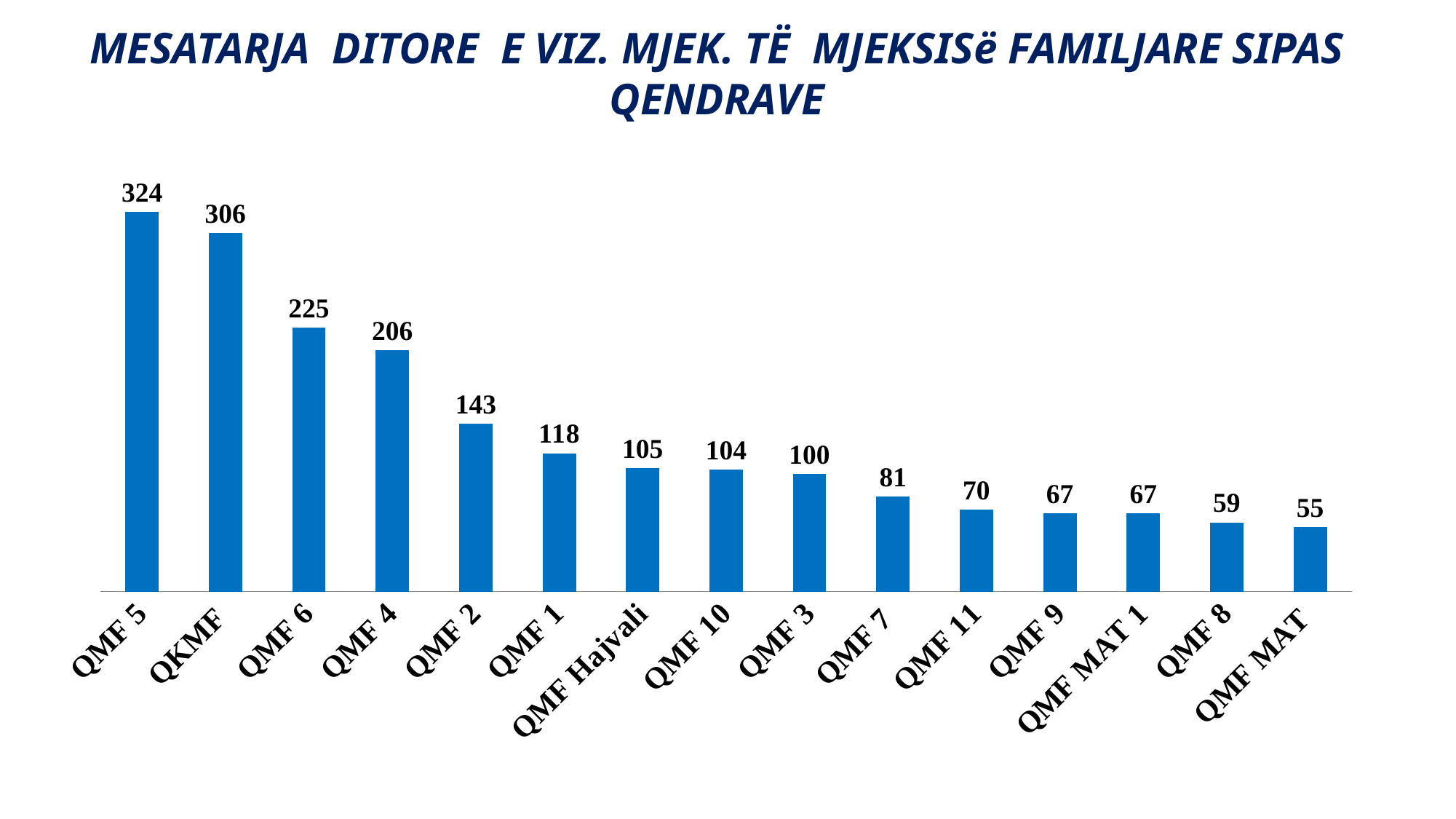
What is the title of the chart? MESATARJA DITORE E VIZ. MJEK. TË MJEKSISë FAMILJARE SIPAS QENDRAVE Which category has the lowest value? QMF MAT Which category has the highest value? QMF 5 What kind of chart is shown on the slide? Bar chart What is the difference between the values for QMF 6 and QMF 4? 19 What is the value for QMF 5? 324 What is the difference between the values for QMF 5 and QKMF? 18 What is the value for QMF MAT 1? 67 How many categories are shown in the chart? 15 What is the value for QMF Hajvali? 105 Which is larger, the value for QMF 2 or the value for QMF 1? QMF 2 Do the values rise or fall from left to right along the x axis? Fall